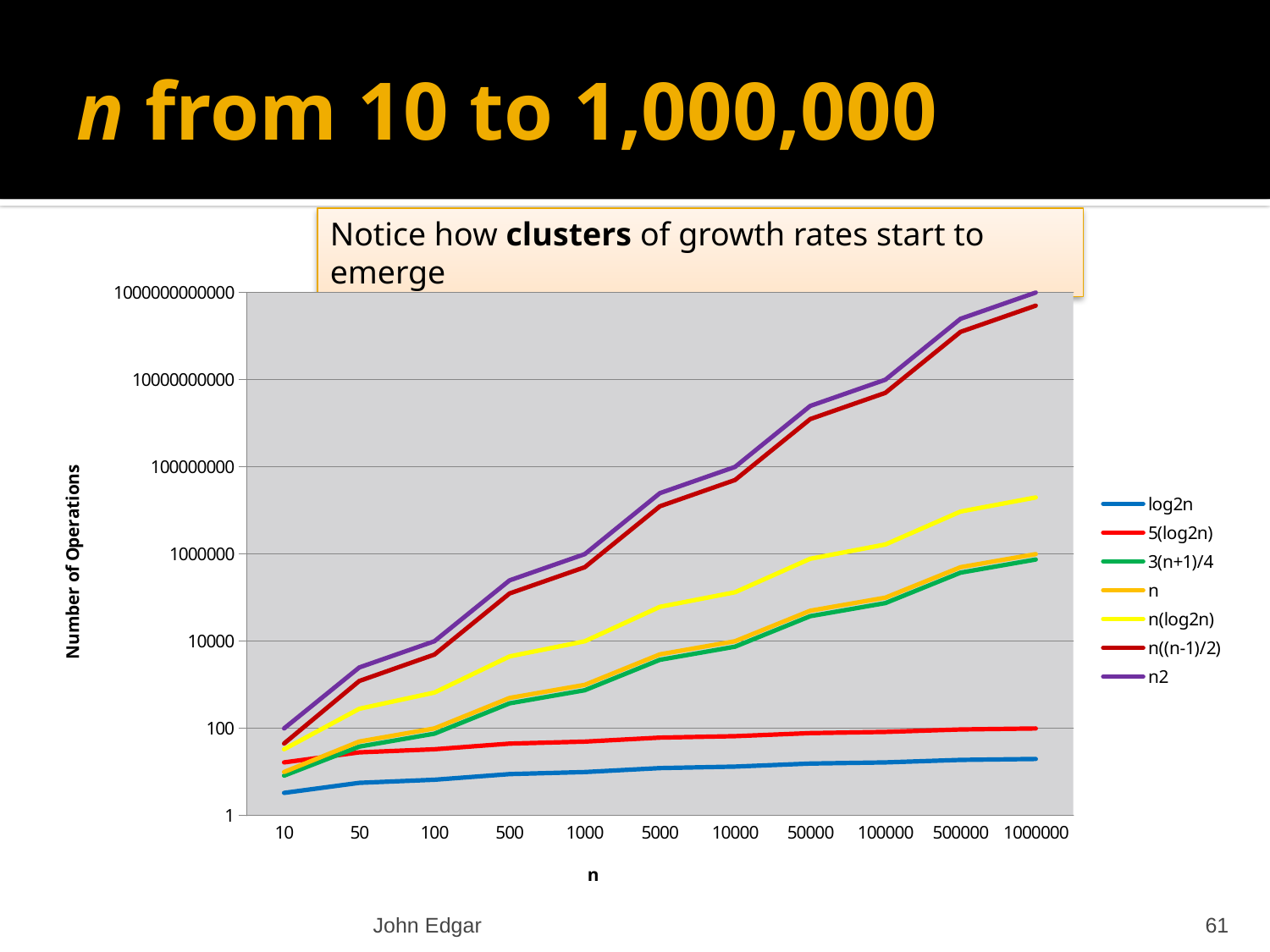
Do the values of the n2 series rise or fall as n increases along the x axis? rise Is the value of 5(log2n) at n = 1000000 greater or less than 10000? less At n = 1000000, which series is larger: n(log2n) or 5(log2n)? n(log2n) Which series has the highest number of operations at n = 1000000? n2 Which series has the lowest number of operations at n = 1000000? log2n How many series does the legend list? 7 How many values of n are plotted along the x axis? 11 What is the label of the y axis? Number of Operations What is the label of the x axis? n What kind of chart is shown on the slide? line chart Is the value of n((n-1)/2) at n = 1000000 greater or less than 10000000000? greater At n = 10, which series is larger: n2 or n? n2